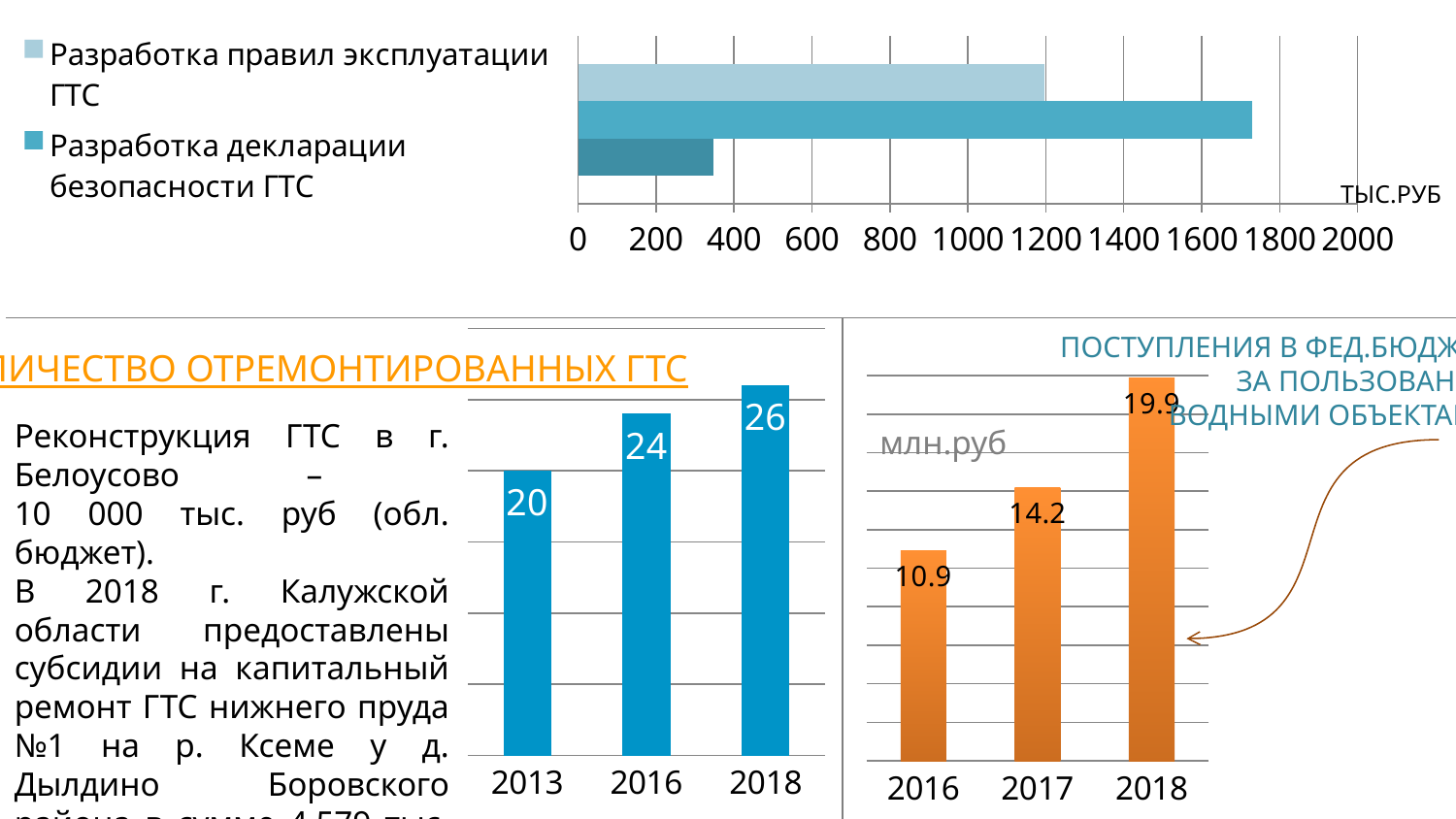
In the top chart, how many entries does the legend list? 2 In the bottom-right chart, what is the difference between the values for 2018 and 2017? 5.7 In the bottom-left chart, what is the difference between the values for 2018 and 2013? 6 In the bottom-right chart, how many years are shown? 3 In the bottom-right chart, which year has the lowest value? 2016 In the bottom-left chart, what is the value for 2018? 26 In the bottom-right chart, what is the value for 2016? 10.9 In the bottom-right chart, what is the value for 2017? 14.2 In the bottom-left chart, do the values rise or fall from 2013 to 2018? rise In the bottom-left chart, which year has the highest value? 2018 In the top chart, is the value of the longest bar greater or less than 1600? greater In the bottom-left chart, what is the value for 2013? 20